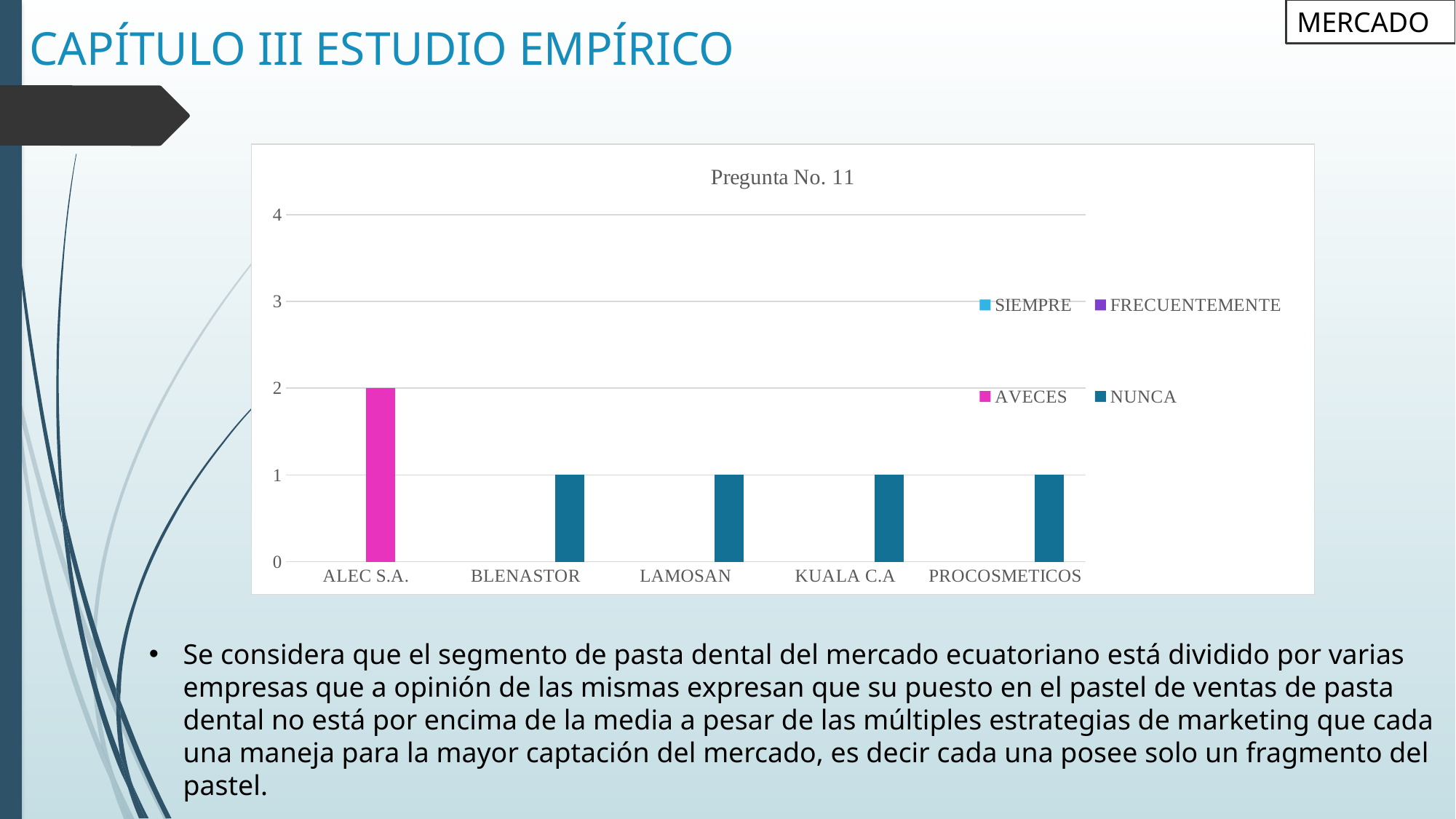
Which is larger, the bar for ALEC S.A. or the bar for KUALA C.A? ALEC S.A. How many companies are listed along the x axis of the chart? 5 What is the NUNCA value for BLENASTOR? 1 How many series does the chart's legend list? 4 What is the AVECES value for ALEC S.A.? 2 What is the NUNCA value for PROCOSMETICOS? 1 What is the title of the chart? Pregunta No. 11 What is the difference between the ALEC S.A. bar and the LAMOSAN bar? 1 Which legend series is shown in magenta/pink? AVECES What kind of chart is shown on the slide? bar chart Is the value for ALEC S.A. greater or less than 3? less Which company has the tallest bar in the chart? ALEC S.A.